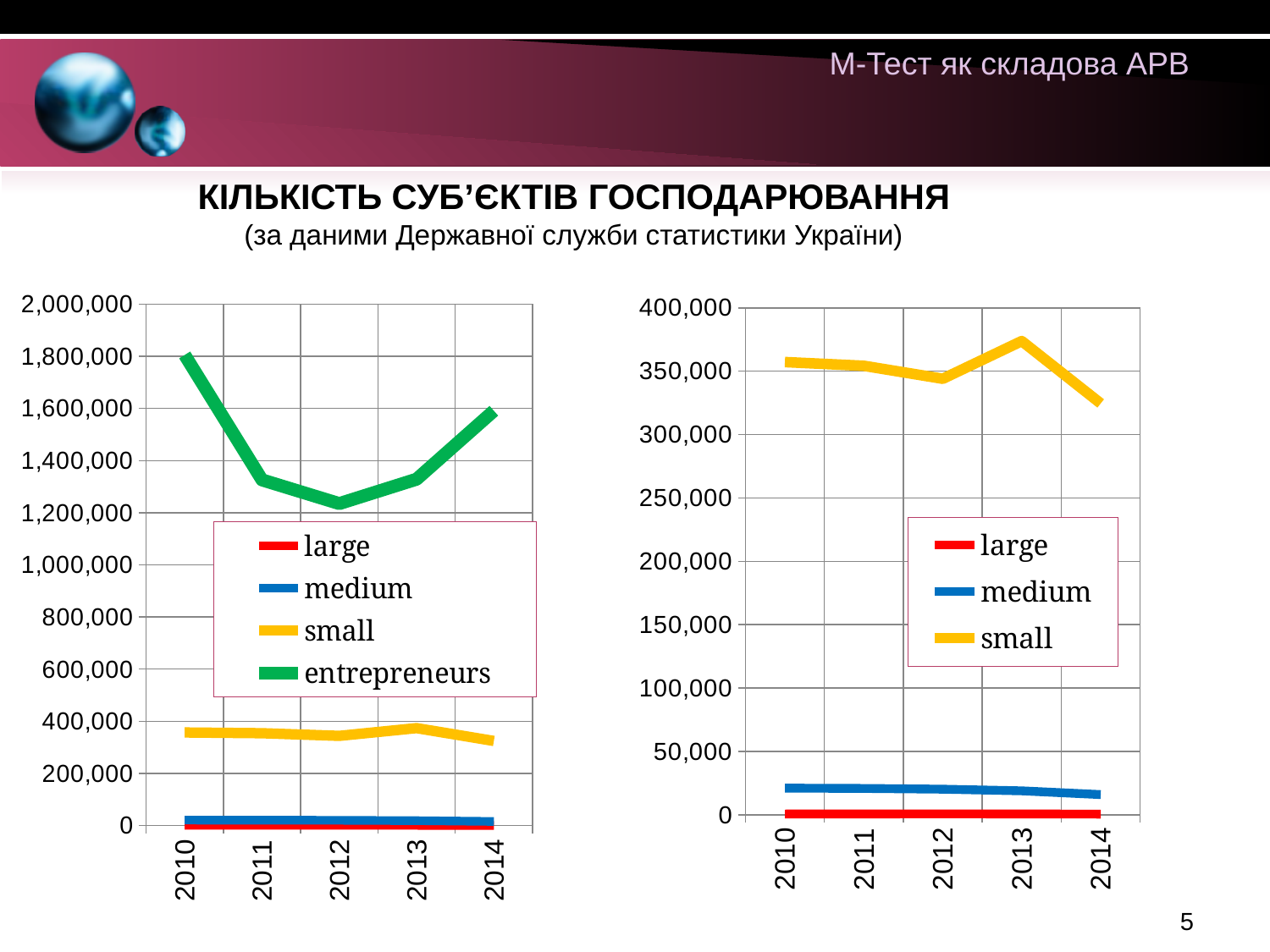
In the left chart, which year has the highest value for entrepreneurs? 2010 In the right chart, is the value for medium in 2010 greater or less than 50,000? less How many series does the legend of the left chart list? 4 In the right chart, which year has the highest value for small? 2013 In the right chart, is the value for small in 2014 greater or less than 350,000? less In the left chart, which year has the lowest value for entrepreneurs? 2012 How many years are shown on the x axis of the right chart? 5 What kind of chart is the left chart on the slide? line chart How many series does the legend of the right chart list? 3 In the left chart, is the value for entrepreneurs in 2012 greater or less than 1,400,000? less In the right chart, which series is plotted in yellow? small